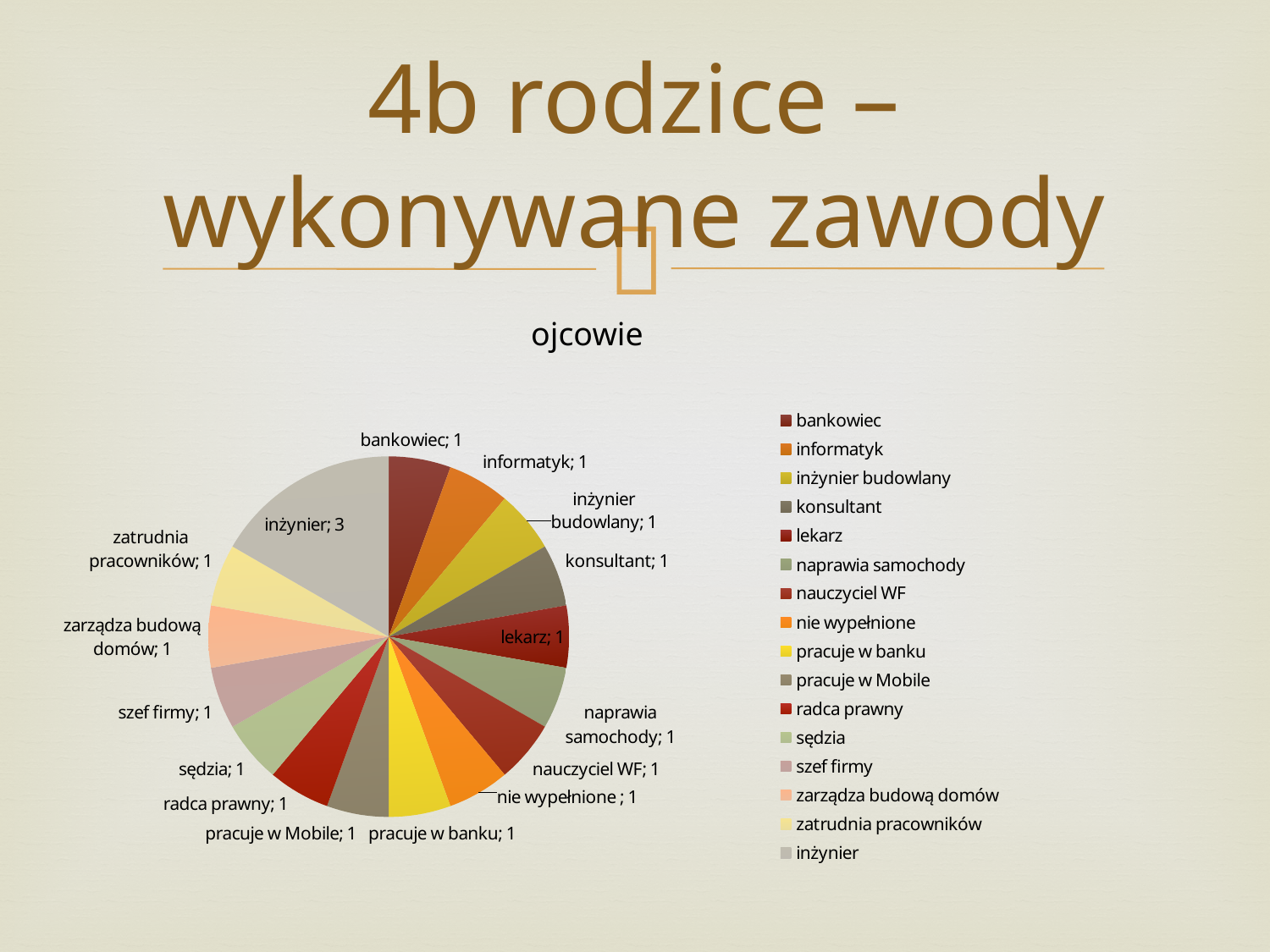
What is the difference between the value for inżynier and the value for bankowiec? 2 What type of chart is shown on the slide? pie chart How many entries does the legend list? 16 What is the value for lekarz? 1 Which category has the largest slice of the pie? inżynier How many categories are shown in the pie chart? 16 Which is larger, the value for inżynier or the value for konsultant? inżynier What is the value for zarządza budową domów? 1 What is the value for inżynier? 3 What is the value for nie wypełnione? 1 What is the title of the chart? ojcowie What is the total of all the values in the pie chart? 18